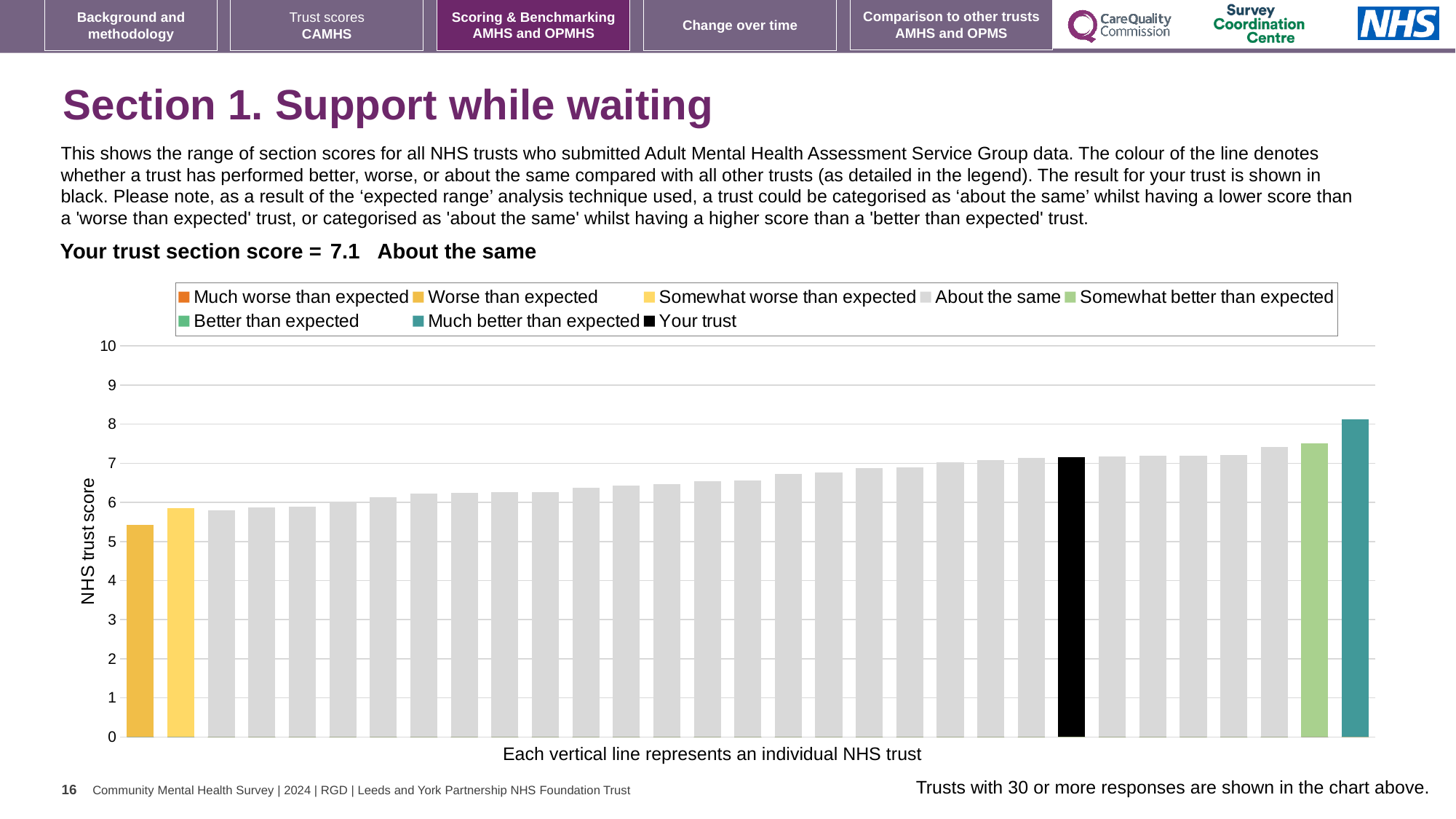
What colour is the bar representing your trust? black What kind of chart is shown on the slide? bar chart What is the section score for your trust shown on the slide? 7.1 Is the value of the leftmost bar greater or less than 5? greater Which legend category does the shortest bar belong to? Worse than expected How many entries does the chart legend list? 8 Do the bar heights rise or fall from left to right across the chart? rise What is the label on the vertical axis of the chart? NHS trust score Is the value of the leftmost bar greater or less than 6? less Is the value of the rightmost bar greater or less than 8? greater Which is taller: the black bar for your trust or the leftmost bar? the black bar for your trust Which legend category does the tallest bar belong to? Much better than expected